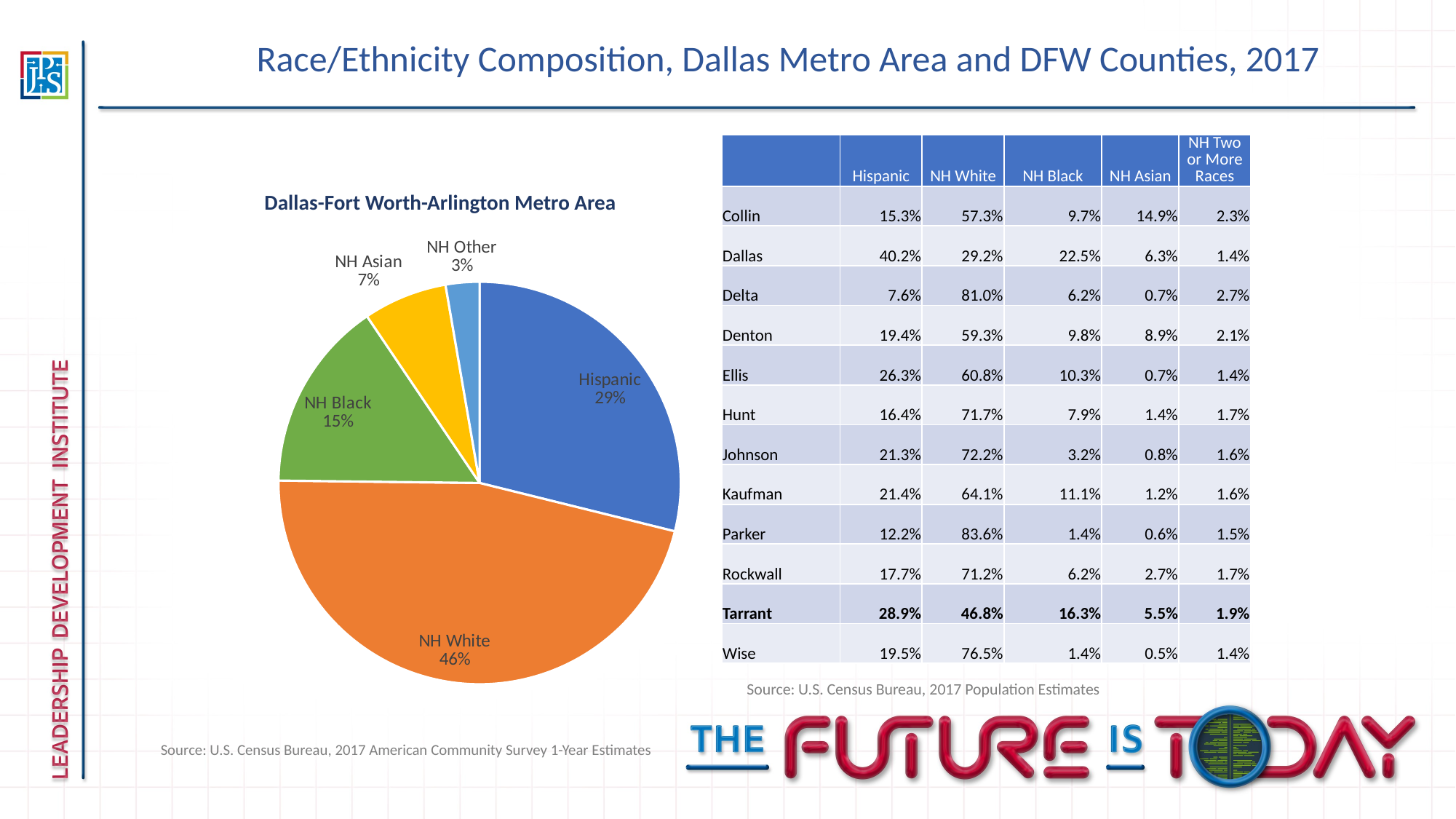
What type of chart is shown on the left of the slide? Pie chart What colour is the NH White slice in the pie chart? Orange What is the title of the pie chart? Dallas-Fort Worth-Arlington Metro Area What percentage is shown for Hispanic in the pie chart? 29% Which category has the smallest slice in the pie chart? NH Other What is the value for NH Black in the pie chart? 15% How many slices does the pie chart have? 5 Which category has the largest slice in the pie chart? NH White What share of the pie chart does NH White represent? 46% Which is larger in the pie chart, NH Black or NH Asian? NH Black What is the difference in percentage points between NH White and Hispanic in the pie chart? 17 What percentage does the NH Asian slice show? 7%